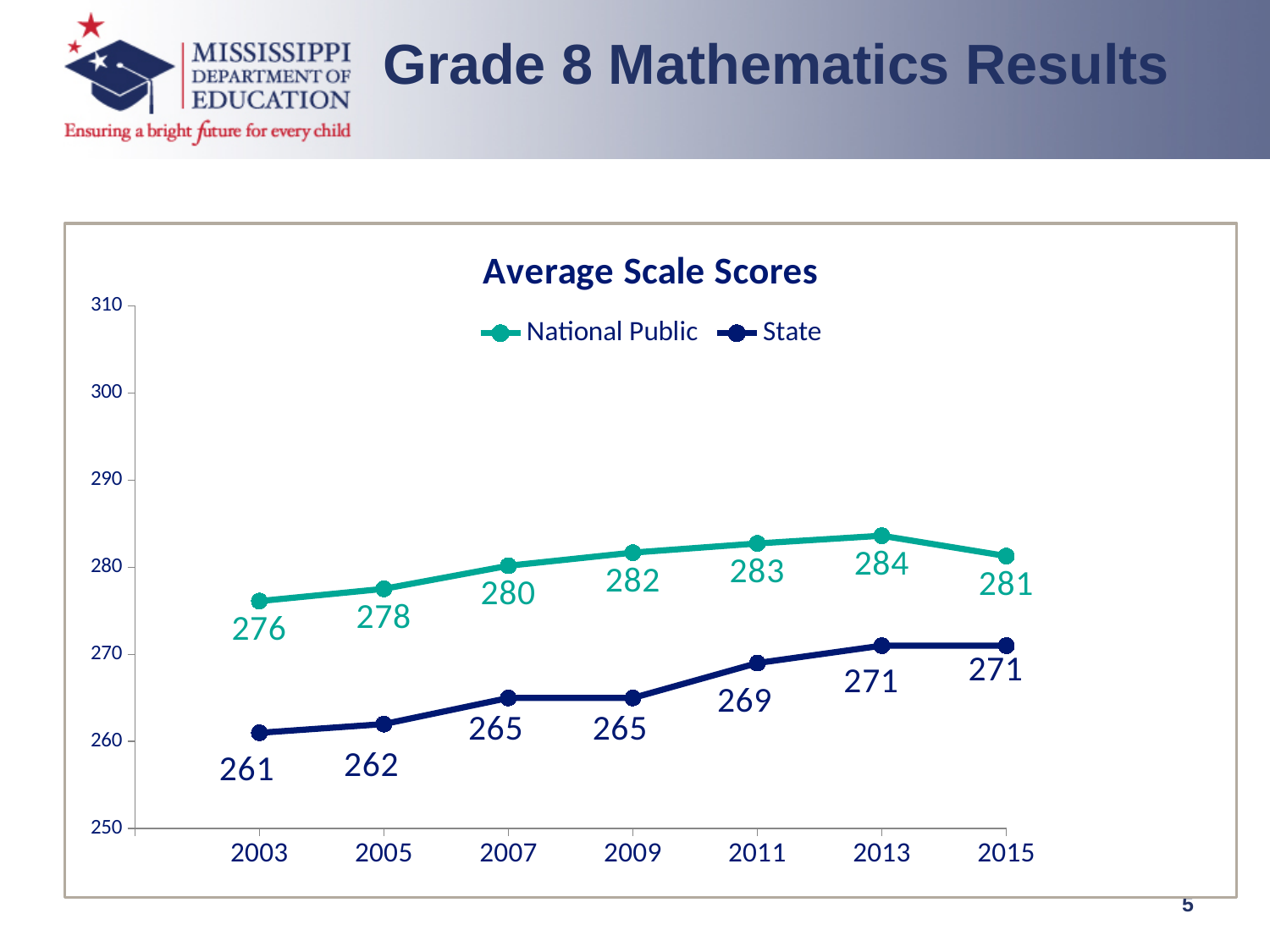
What is the National Public average scale score in 2009? 282 What is the title of the chart? Average Scale Scores Which is larger in 2007, the National Public score or the State score? National Public How many years are shown on the x axis? 7 By how much did the State score increase from 2003 to 2015? 10 Is the State score in 2013 greater or less than 280? less In which year is the State score lowest? 2003 What is the State average scale score in 2011? 269 What kind of chart is shown on the slide? line chart What is the difference between the National Public and State scores in 2015? 10 How many series does the legend list? 2 In which year is the National Public score highest? 2013